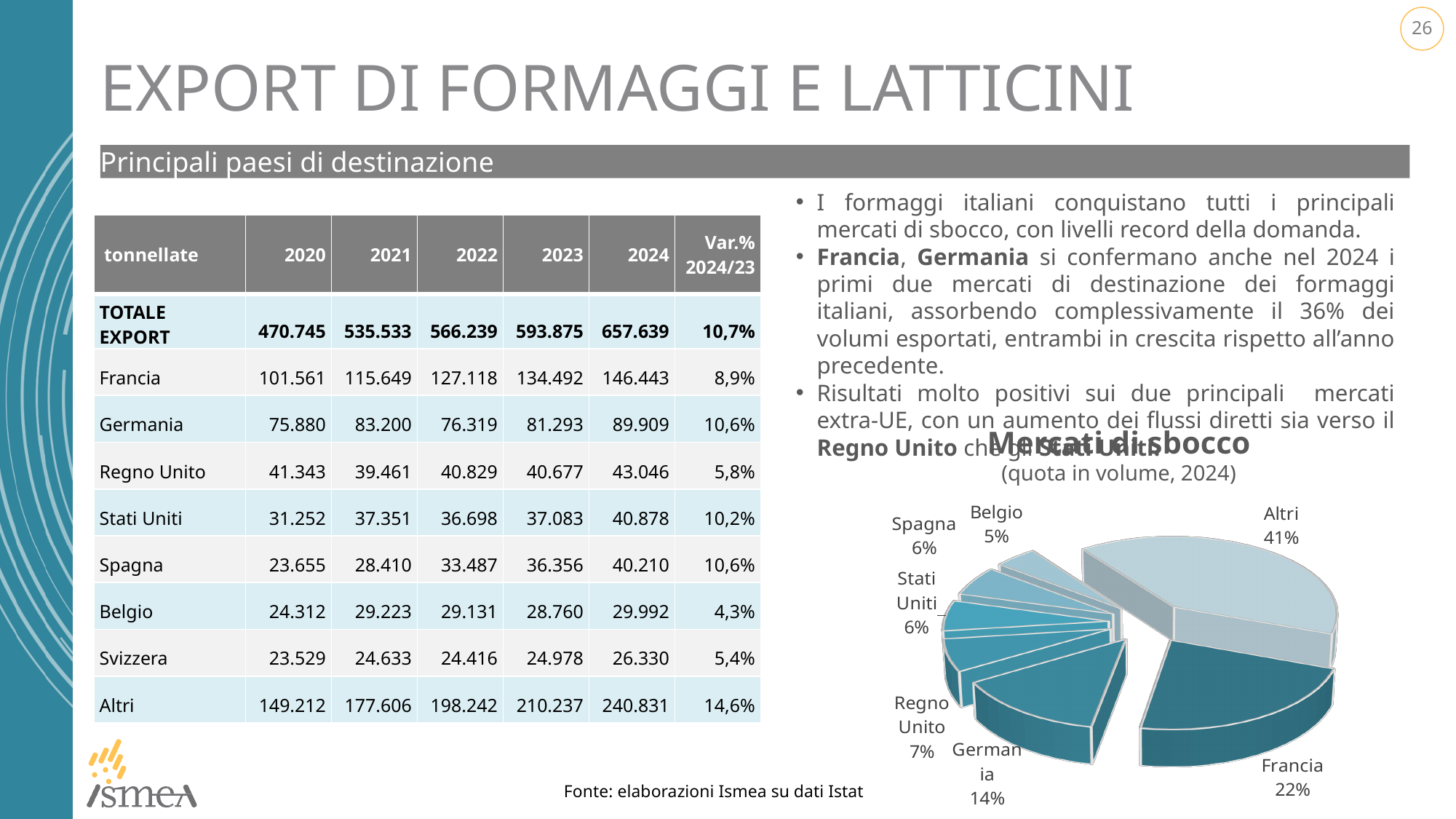
In the pie chart "Mercati di sbocco", what share does Germania hold? 14% In the pie chart "Mercati di sbocco", how many slices are there? 7 What kind of chart is shown under the title "Mercati di sbocco"? pie chart In the pie chart "Mercati di sbocco", which slice is the smallest? Belgio In the pie chart "Mercati di sbocco", what share does Francia hold? 22% In the pie chart "Mercati di sbocco", what share does Belgio hold? 5% In the pie chart "Mercati di sbocco", what share does Regno Unito hold? 7% In the pie chart "Mercati di sbocco", which slice is the largest? Altri What is the subtitle shown under the pie chart title "Mercati di sbocco"? (quota in volume, 2024) In the pie chart "Mercati di sbocco", which is larger, the share of Francia or the share of Germania? Francia In the pie chart "Mercati di sbocco", what is the difference in percentage points between the Altri slice and the Francia slice? 19 percentage points In the pie chart "Mercati di sbocco", what is the combined share of Francia and Germania? 36%